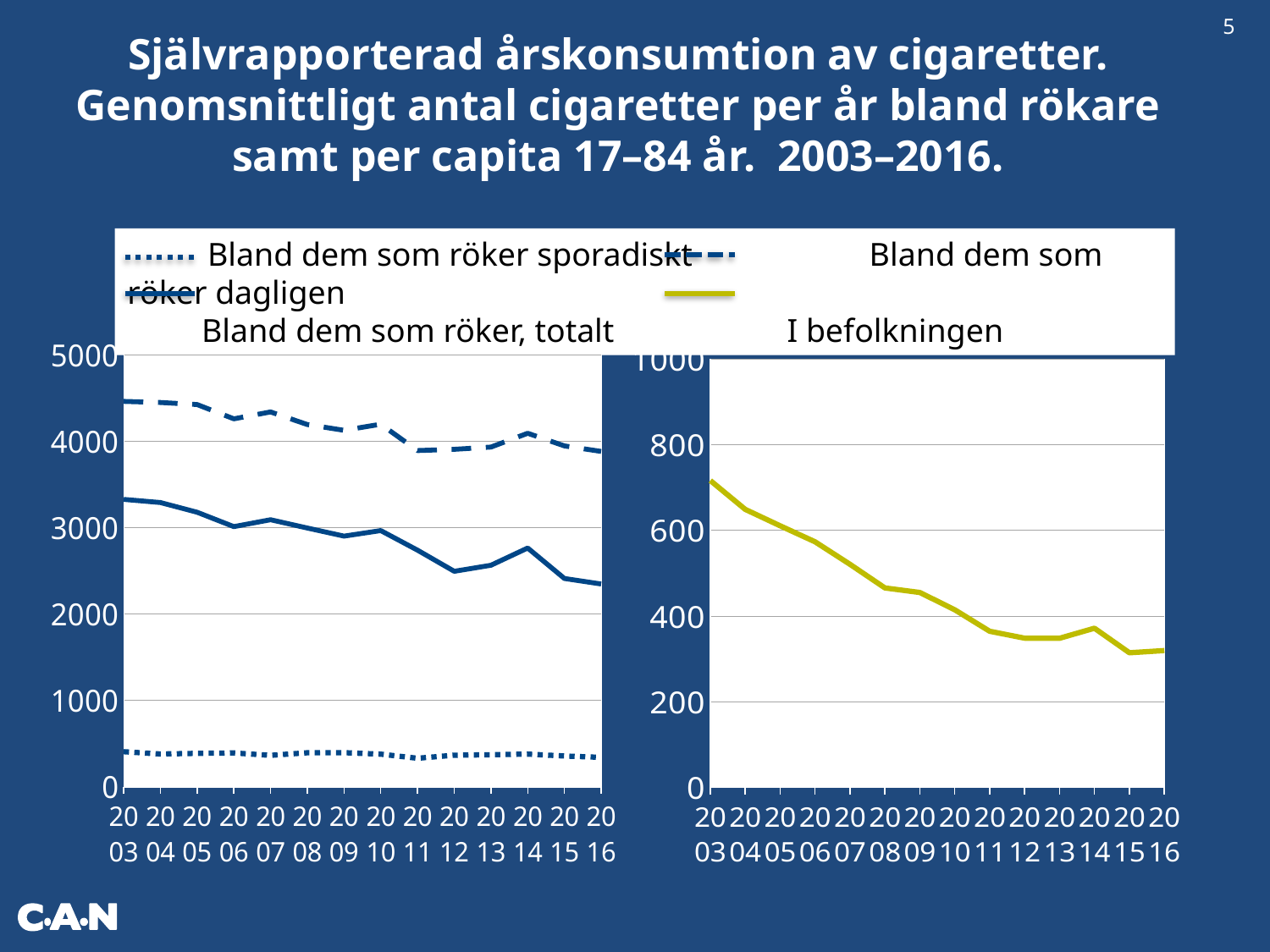
How many series does the legend list? 4 In the left chart, does the 'Bland dem som röker, totalt' line rise or fall from 2003 to 2016? fall What kind of chart is the left chart on the slide? line chart In the left chart, which is larger in 2003: 'Bland dem som röker dagligen' or 'Bland dem som röker, totalt'? Bland dem som röker dagligen In the right chart, does the 'I befolkningen' line rise or fall from 2003 to 2016? fall In the left chart, is the value for 'Bland dem som röker sporadiskt' in 2010 greater or less than 1000? less In the right chart, which year has the highest value for 'I befolkningen'? 2003 In the right chart, is the value for 'I befolkningen' in 2003 greater or less than 600? greater How many years are shown on the x axis of the left chart? 14 In the left chart, is the value for 'Bland dem som röker dagligen' in 2003 greater or less than 4000? greater Which series in the legend is drawn with a dotted line? Bland dem som röker sporadiskt